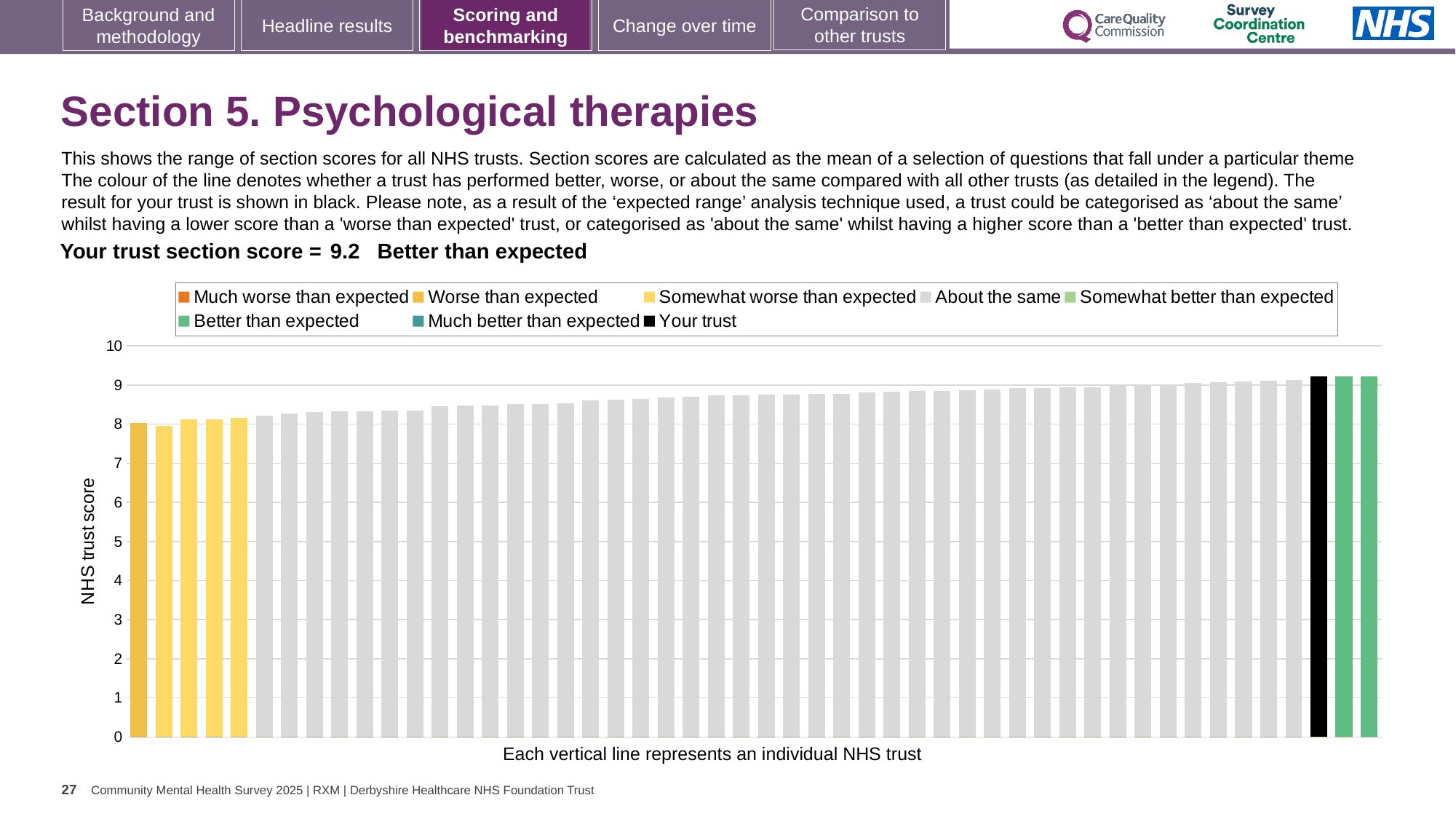
How many green bars are shown in the chart? 2 What is the section score for your trust shown on the slide? 9.2 Do the bar values rise or fall from left to right across the chart? rise Which is higher: the bar for your trust or the leftmost bar? your trust Is the value of the leftmost bar greater or less than 7? greater Is the value of the rightmost bar greater or less than 10? less How many entries does the chart legend list? 8 Is the value of the leftmost bar greater or less than 9? less What colour is the bar representing your trust? black What is the label on the vertical axis of the chart? NHS trust score How is your trust's section score categorised according to the slide? Better than expected What type of chart is shown on the slide? bar chart